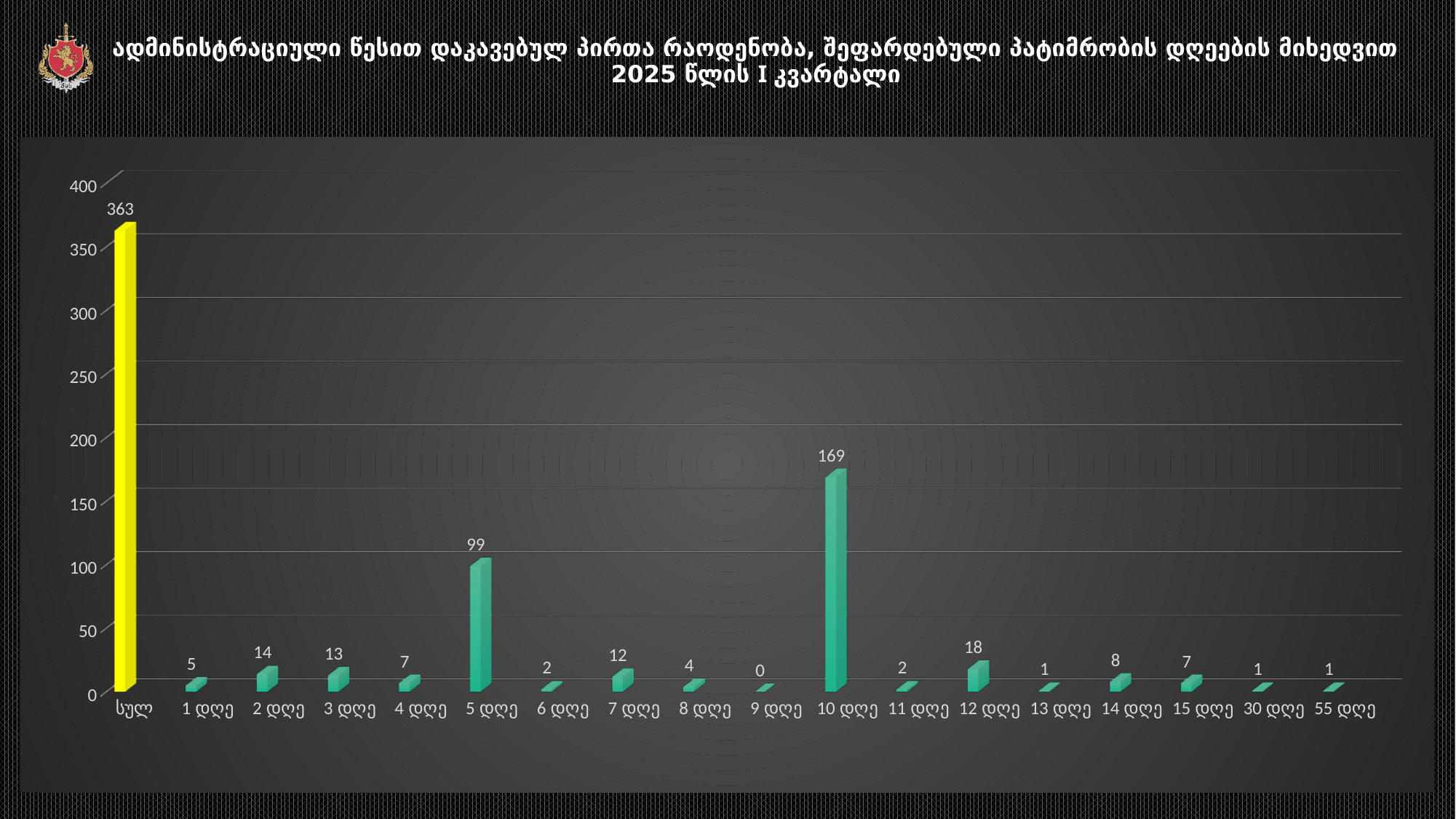
What kind of chart is shown on the slide? bar chart Excluding the "სულ" total bar, which category has the highest value? 10 დღე Which category has the lowest value? 9 დღე Is the value for "სულ" greater or less than 350? greater What is the value for "10 დღე"? 169 What is the difference between the values for "10 დღე" and "5 დღე"? 70 How many categories are shown on the x axis? 18 What is the value for "9 დღე"? 0 Which is larger, the value for "12 დღე" or the value for "2 დღე"? 12 დღე What colour is the "სულ" bar? yellow What is the value for the "სულ" bar? 363 What is the value for "5 დღე"? 99